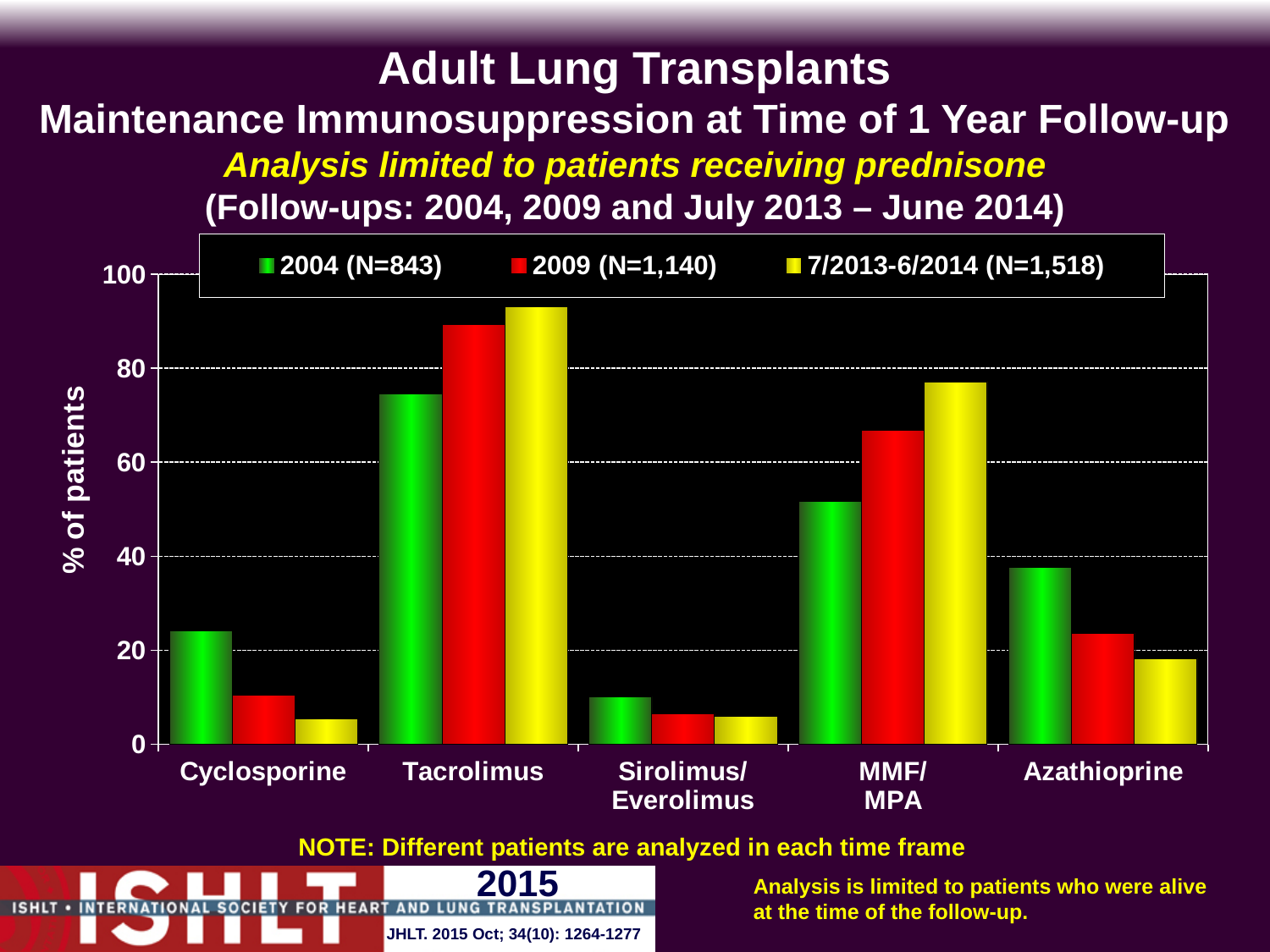
What is the label on the y axis? % of patients Do the values for Azathioprine rise or fall from 2004 to 7/2013-6/2014? fall Is the value for Tacrolimus in 2009 greater or less than 80? greater What kind of chart is shown on the slide? Bar chart Is the value for MMF/MPA in 2004 greater or less than 60? less How many drug categories are shown on the x axis? 5 Which drug category has the highest value for the 2004 series? Tacrolimus For Cyclosporine, which series has the larger value: 2004 or 2009? 2004 Do the values for Tacrolimus rise or fall from 2004 to 7/2013-6/2014? rise Which drug category has the lowest value for the 2004 series? Sirolimus/Everolimus How many series does the legend list? 3 For the 2004 series, which is larger: Azathioprine or MMF/MPA? MMF/MPA